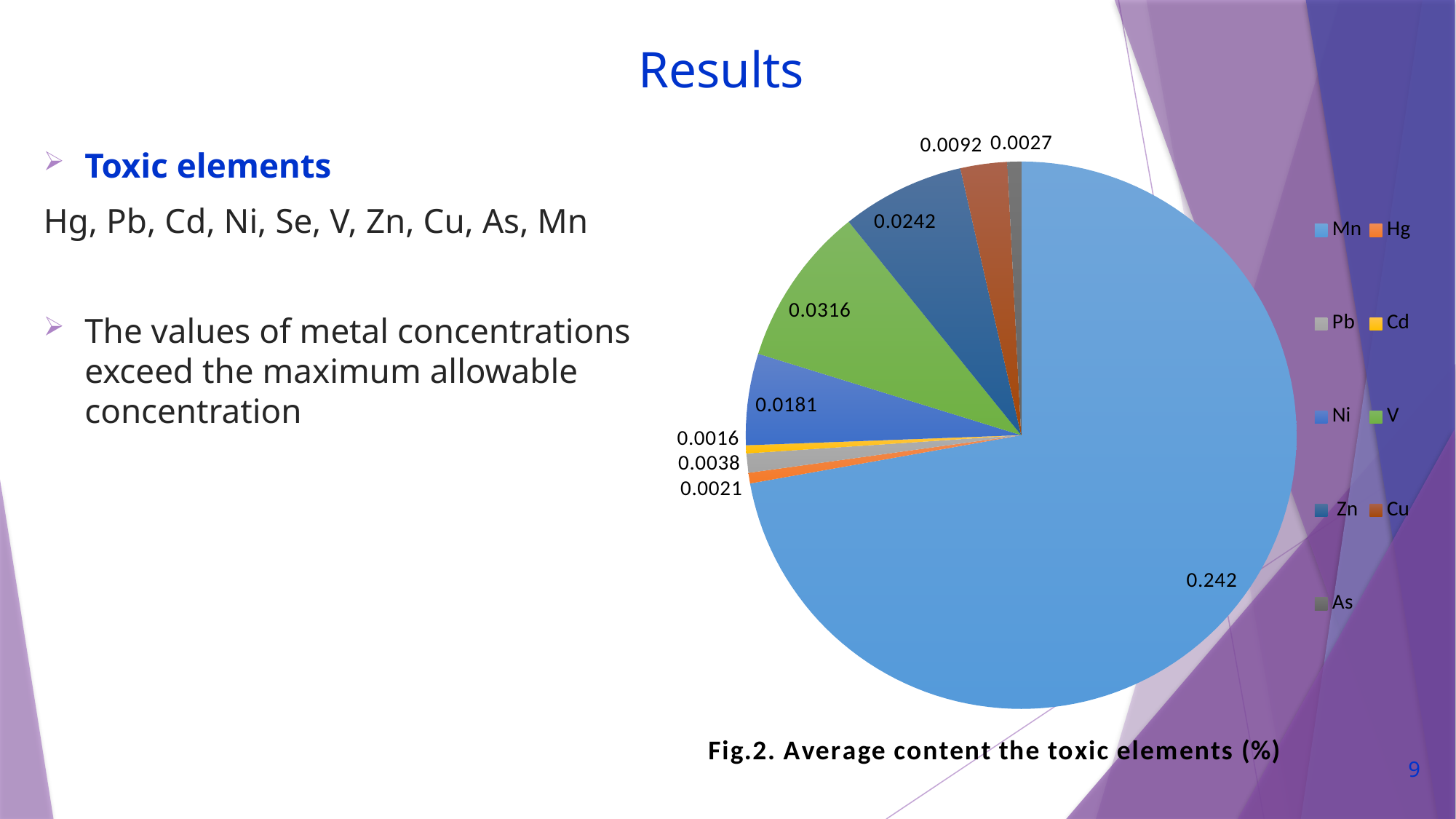
What is the value shown for Cu in the pie chart? 0.0092 Which element has the largest slice in the pie chart? Mn What is the value shown for Zn in the pie chart? 0.0242 How many elements are shown in the pie chart? 9 What is the value shown for Ni in the pie chart? 0.0181 What is the value shown for Mn in the pie chart? 0.242 What is the difference between the values for V and Zn? 0.0074 What is the value shown for V in the pie chart? 0.0316 What type of chart is shown on the slide? Pie chart What is the caption of the chart? Fig.2. Average content the toxic elements (%) Which has a larger value, Ni or Zn? Zn Which element has the smallest value in the pie chart? Cd